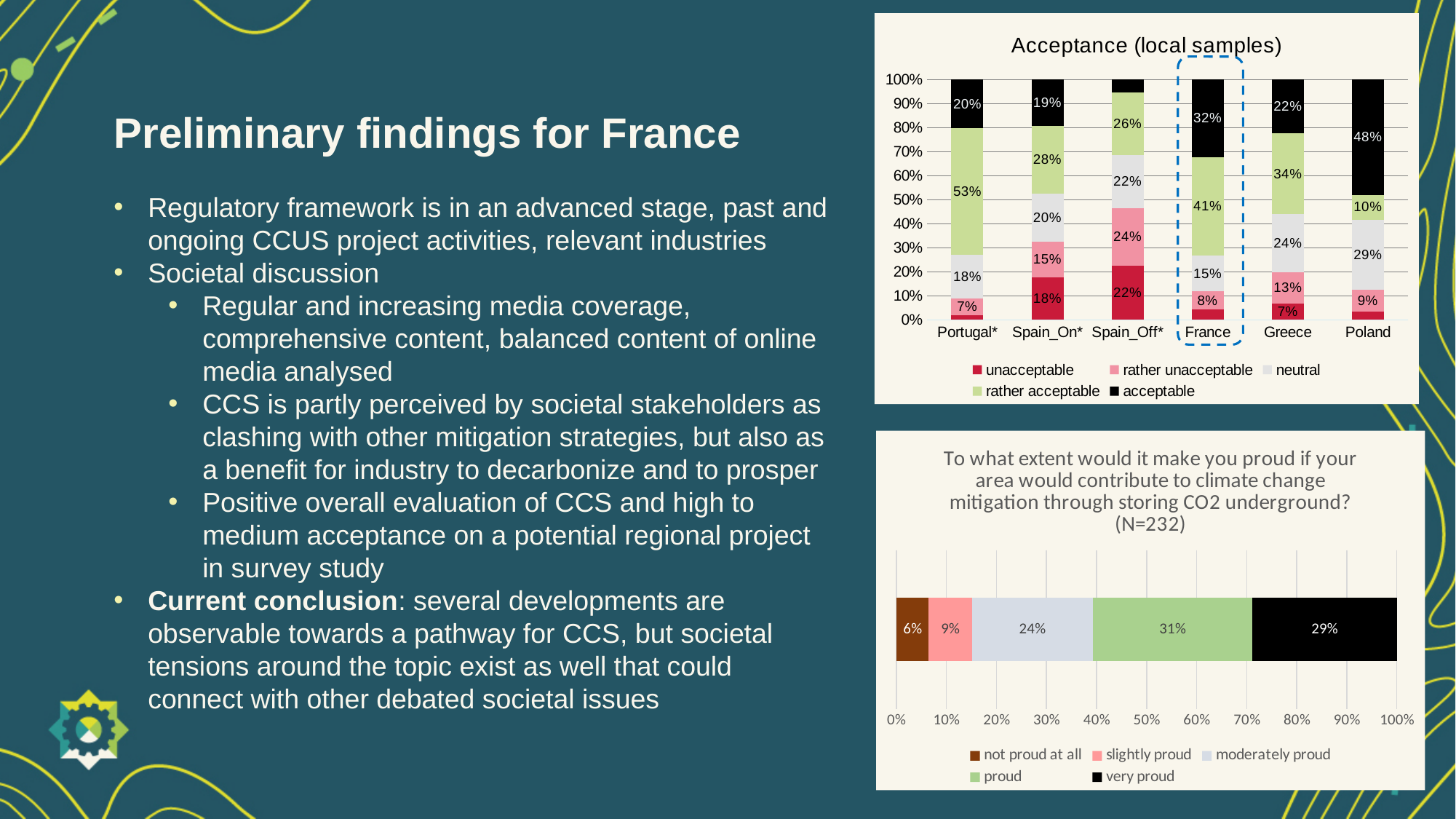
In the bottom chart about pride in contributing to climate change mitigation, what is the combined share of 'proud' and 'very proud' responses? 60% How many series does the legend of the 'Acceptance (local samples)' chart list? 5 What kind of chart is the bottom chart about pride in contributing to climate change mitigation? Stacked bar chart In the 'Acceptance (local samples)' chart, which sample has the highest 'acceptable' share? Poland In the 'Acceptance (local samples)' chart, which sample has the highest 'rather acceptable' share? Portugal* In the 'Acceptance (local samples)' chart, is the 'neutral' share larger for Poland or for Greece? Poland In the bottom chart about pride in contributing to climate change mitigation, what percentage of respondents answered 'proud'? 31% In the 'Acceptance (local samples)' chart, what percentage of the Poland sample is labelled 'acceptable'? 48% In the 'Acceptance (local samples)' chart, how many percentage points higher is the 'acceptable' share for France than for Greece? 10 percentage points In the 'Acceptance (local samples)' chart, what is the 'rather acceptable' value for France? 41% How many samples (categories) are shown on the x axis of the 'Acceptance (local samples)' chart? 6 In the bottom chart about pride in contributing to climate change mitigation, which response category has the largest share? proud